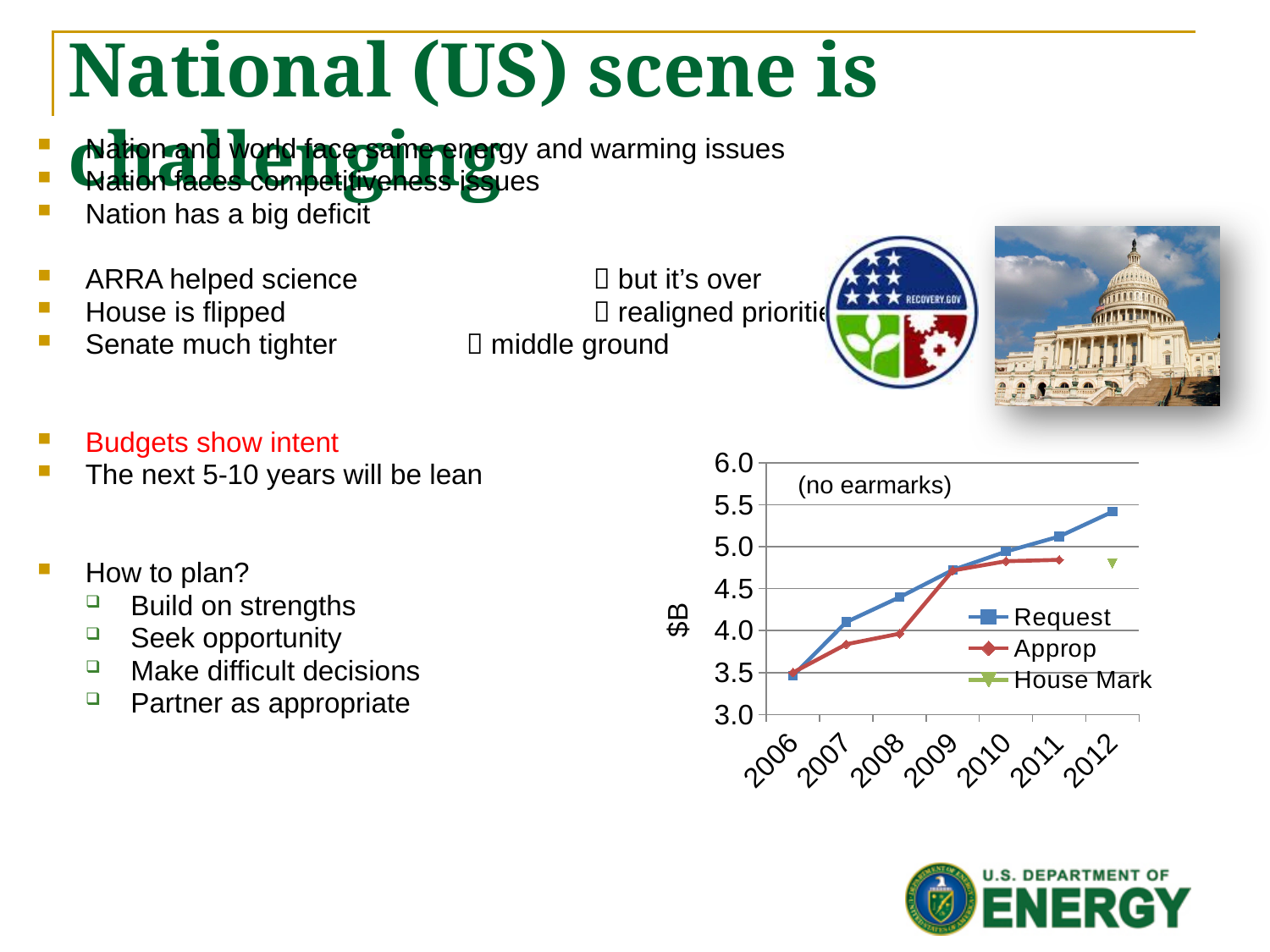
Is the Request value for 2012 greater or less than 5.0? greater In 2012, which is larger: the Request value or the House Mark value? Request Is the House Mark value for 2012 greater or less than 5.0? less How many series does the chart legend list? 3 Does the Request series rise or fall from 2006 to 2012? rise In 2008, which is larger: the Request value or the Approp value? Request What kind of chart is shown on the slide? line chart Is the Request value for 2008 greater or less than 4.0? greater What is the label on the y axis of the chart? $B How many years are shown along the x axis of the chart? 7